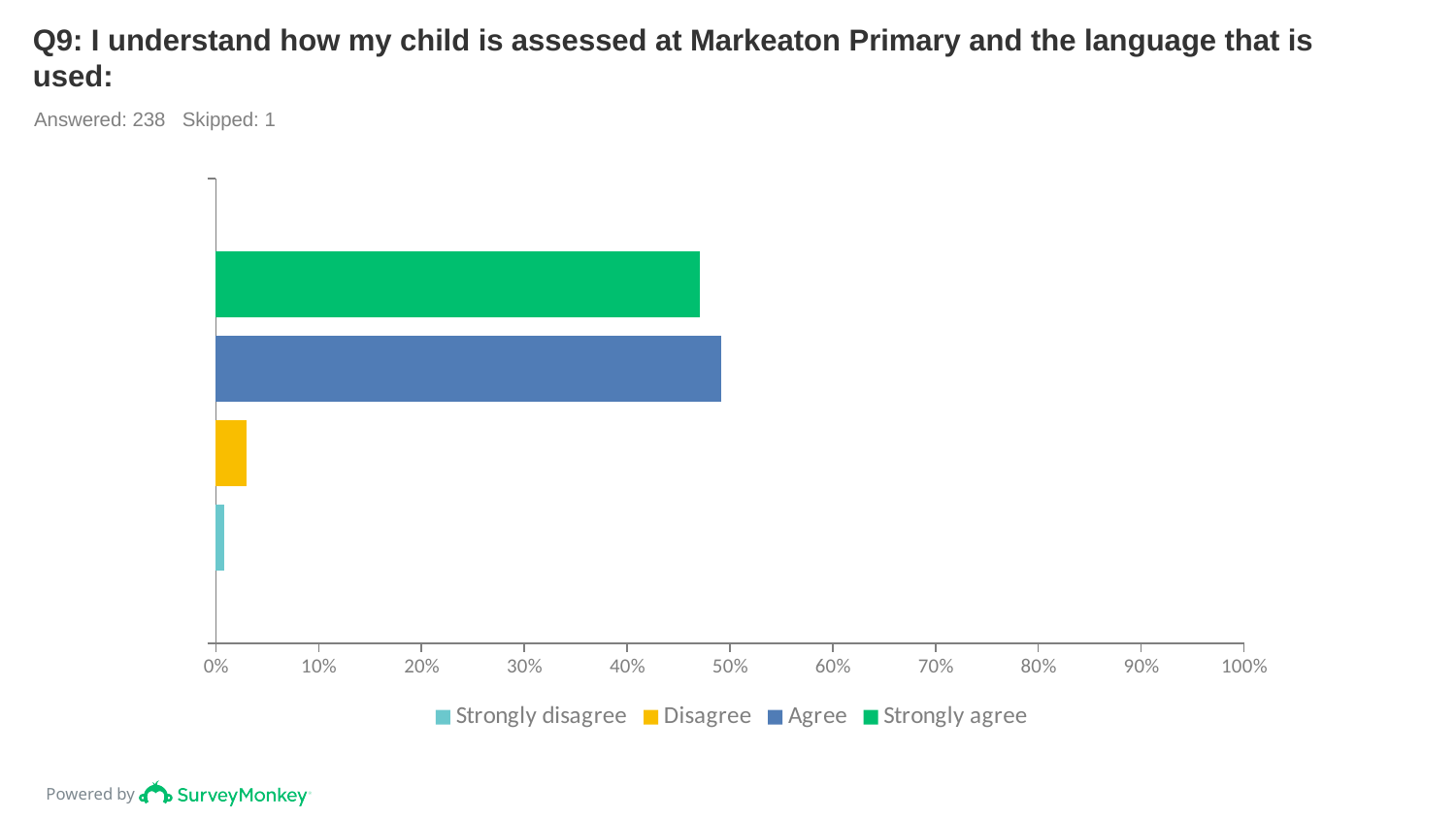
What colour is the bar for Strongly agree? green Is the value for Strongly agree greater or less than 40%? greater How many bars are plotted in the chart? 4 What kind of chart is shown on the slide? bar chart Is the value for Disagree greater or less than 10%? less Is the value for Agree greater or less than 40%? greater Which response option has the lowest value? Strongly disagree Which is larger, the value for Disagree or the value for Strongly disagree? Disagree How many series does the legend list? 4 Which is larger, the value for Agree or the value for Disagree? Agree How many respondents answered this question according to the slide? 238